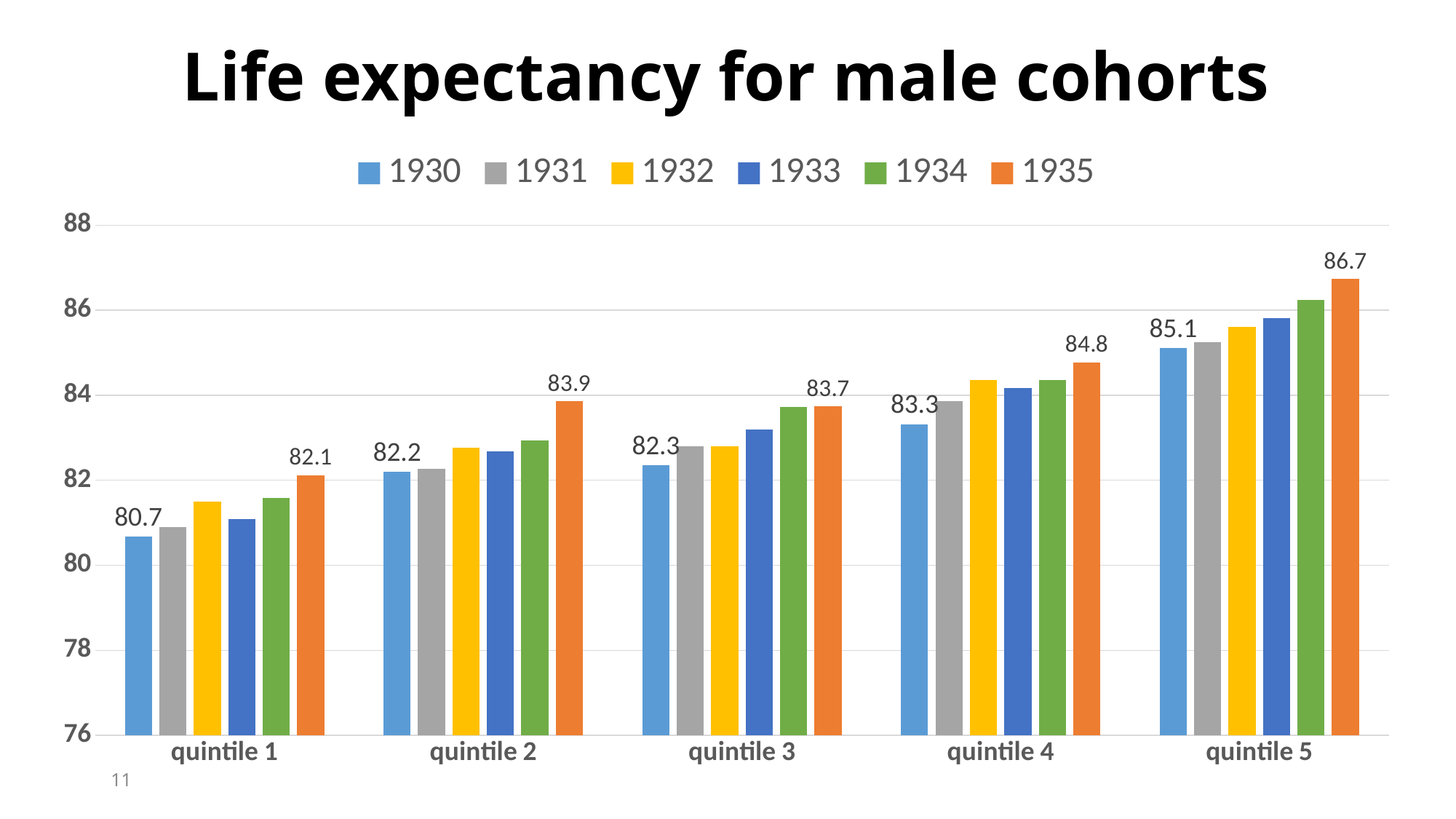
What is the life expectancy for the 1930 cohort in quintile 4? 83.3 What is the life expectancy for the 1935 cohort in quintile 2? 83.9 How many quintile categories are shown on the x axis? 5 What kind of chart is shown on the slide? bar chart Is the value for the 1933 cohort in quintile 3 greater or less than 82? greater What is the difference between the 1935 and 1930 cohort values in quintile 1? 1.4 What is the life expectancy for the 1935 cohort in quintile 5? 86.7 Which is larger: the 1935 value in quintile 2 or the 1935 value in quintile 3? quintile 2 How many series does the legend list? 6 Which quintile has the lowest life expectancy for the 1930 cohort? quintile 1 Which quintile has the highest life expectancy for the 1935 cohort? quintile 5 What is the life expectancy for the 1930 cohort in quintile 1? 80.7